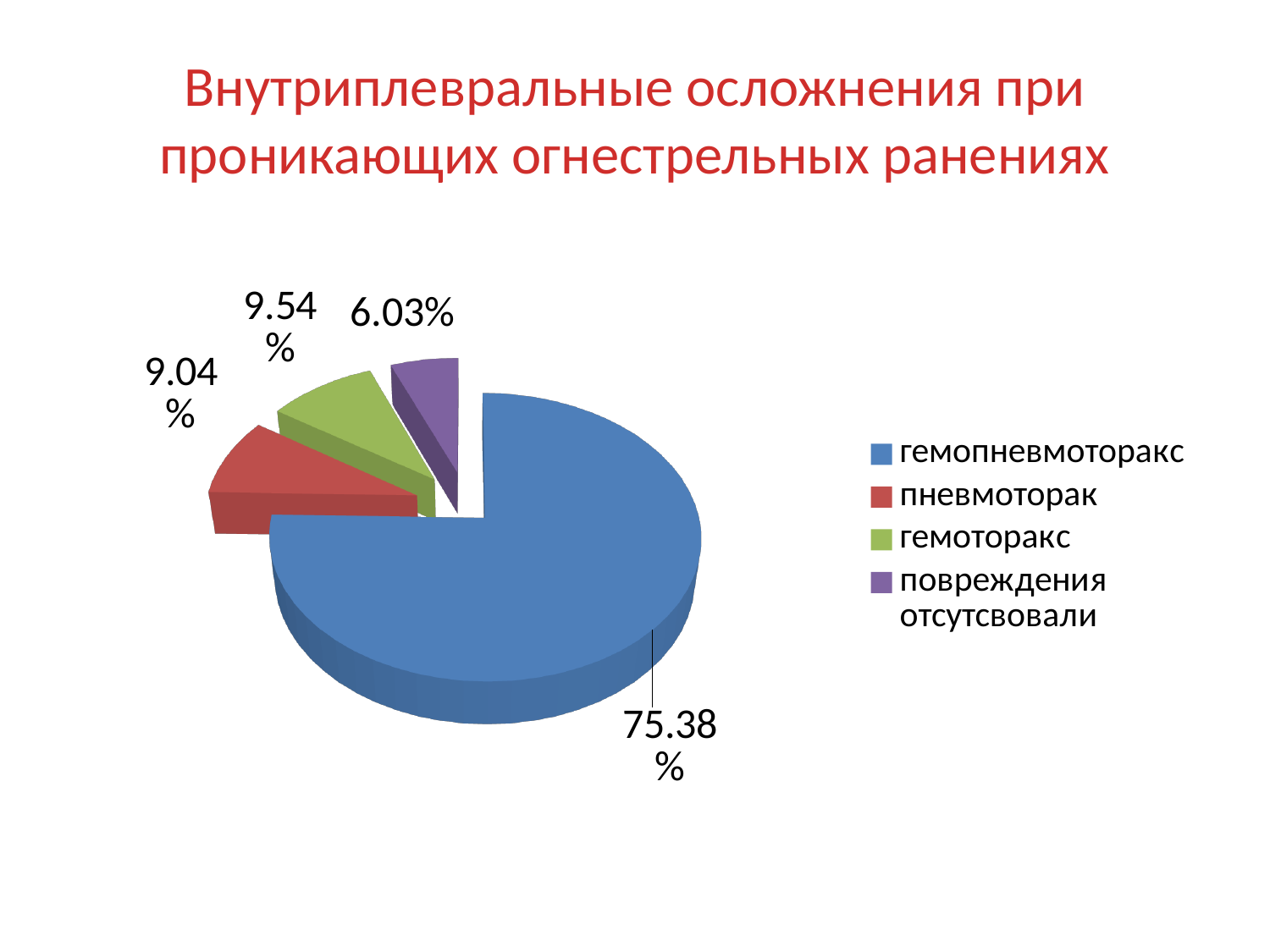
What is the value shown for повреждения отсутсвовали? 6.03% Which is larger, the slice for гемоторакс or the slice for пневмоторак? гемоторакс What is the difference between the values for гемоторакс and пневмоторак? 0.50% What is the value shown for пневмоторак? 9.04% What is the difference between the values for гемопневмоторакс and гемоторакс? 65.84% Which category has the smallest slice of the pie? повреждения отсутсвовали What type of chart is shown on the slide? pie chart What share of the pie does гемопневмоторакс take? 75.38% What is the value shown for гемоторакс? 9.54% Which category has the largest slice of the pie? гемопневмоторакс How many categories does the legend list? 4 What colour is the slice for гемопневмоторакс? blue